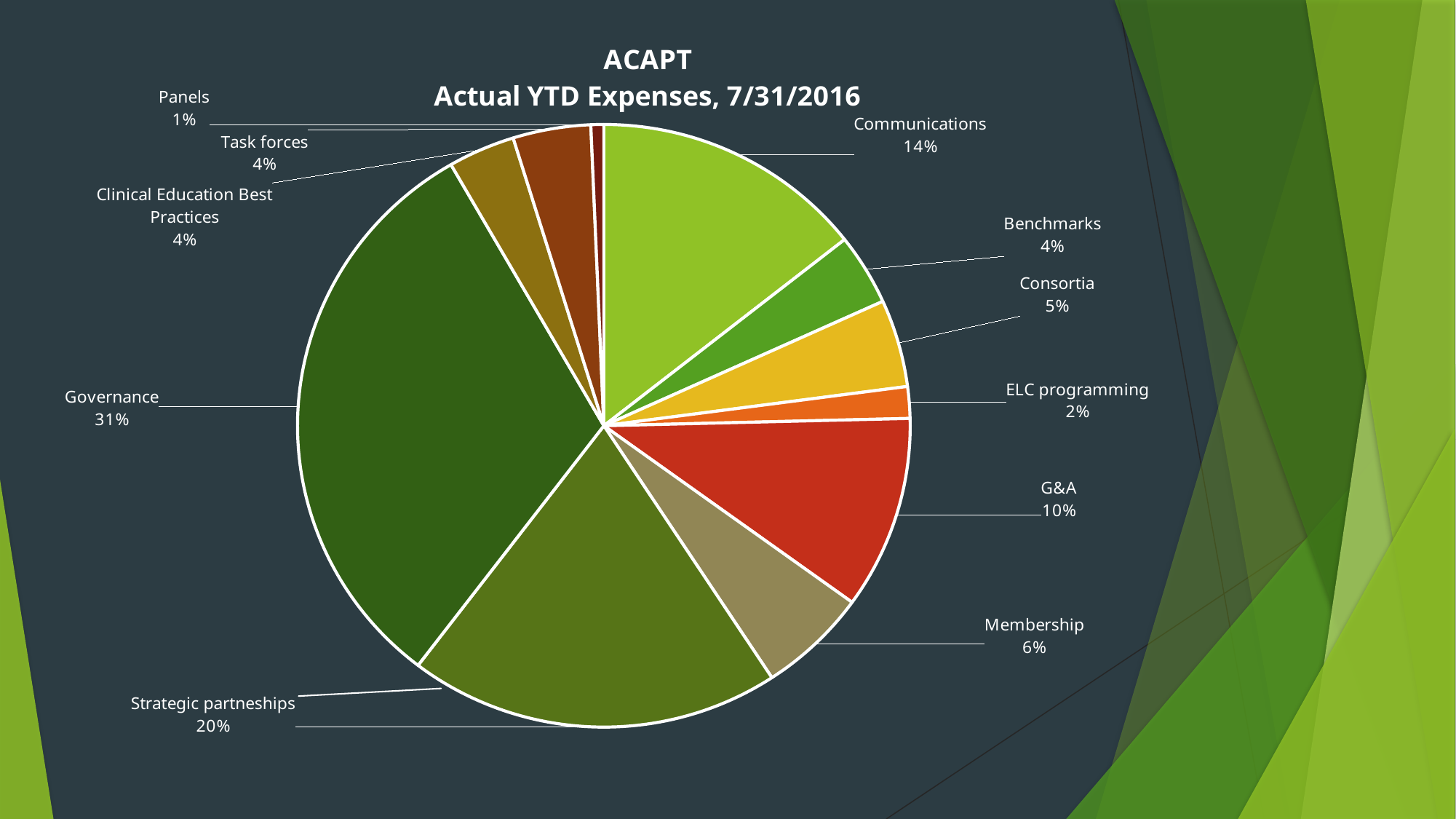
Which category has the smallest share of the pie? Panels What share of expenses does Governance account for? 31% What is the title of the chart? ACAPT Actual YTD Expenses, 7/31/2016 What percentage is shown for ELC programming? 2% What percentage is shown for Communications? 14% Which is larger, the share for Membership or the share for Consortia? Membership Which category has the largest share of the pie? Governance What is the difference in percentage points between Governance and Strategic partneships? 11 What percentage is shown for G&A? 10% How many categories are shown in the pie chart? 11 What kind of chart is shown on the slide? Pie chart What is the combined share of Communications and G&A? 24%